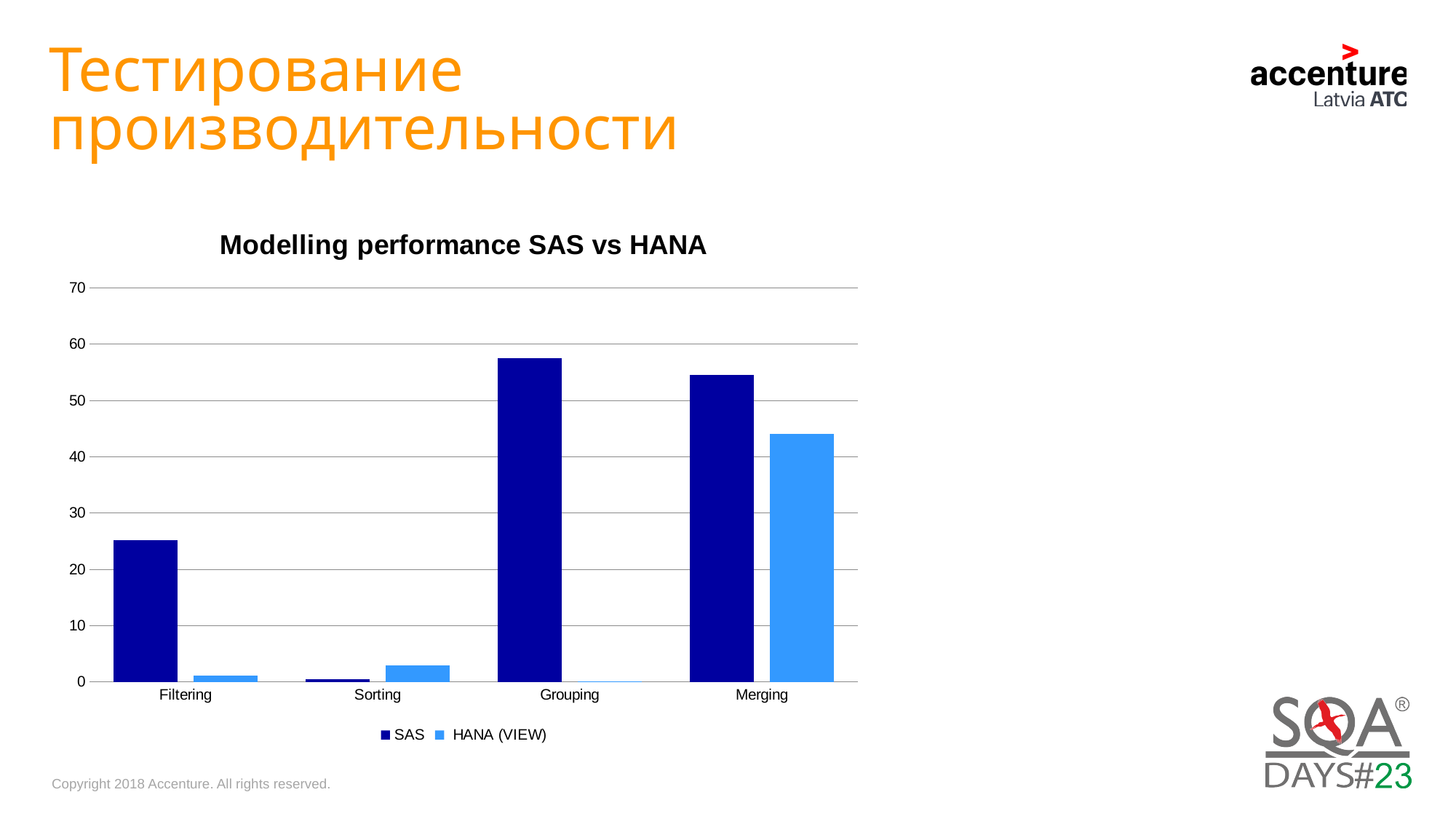
Which category has the highest HANA (VIEW) value? Merging What type of chart is shown on the slide? bar chart How many series does the legend list? 2 Which category has the lowest SAS value? Sorting What is the title of the chart? Modelling performance SAS vs HANA How many categories are shown on the x axis? 4 Is the SAS value for Grouping greater or less than 50? greater Which category has the highest SAS value? Grouping For Merging, which series has the larger value, SAS or HANA (VIEW)? SAS Is the HANA (VIEW) value for Merging greater or less than 40? greater For Sorting, which series has the larger value, SAS or HANA (VIEW)? HANA (VIEW) Is the SAS value for Filtering greater or less than 20? greater